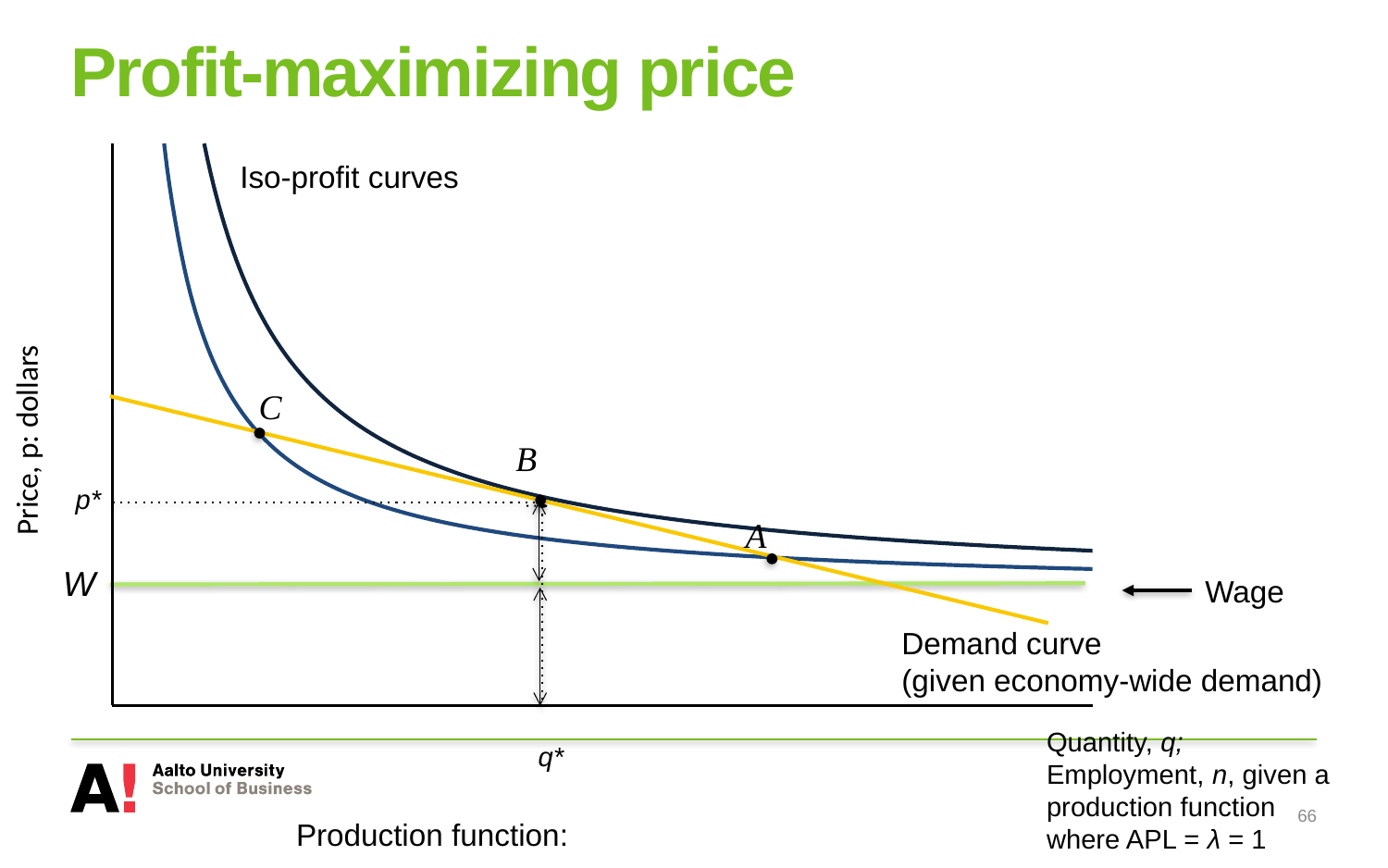
Which of the labeled points A, B or C lies at the highest price? C Which is higher on the price axis, p* or W? p* What is the label of the horizontal green line on the chart? W (Wage) What is the label of the vertical axis? Price, p: dollars How many labeled points (A, B, C) are marked on the chart? 3 What kind of chart is shown on the slide? line chart Which point lies at a higher price, point B or point A? B What is the yellow downward-sloping line labeled as? Demand curve (given economy-wide demand) Does the demand curve rise or fall as quantity increases along the x axis? fall Which labeled point corresponds to the quantity q* on the x axis? B How many iso-profit curves are drawn on the chart? 2 Which of the labeled points A, B or C lies at the lowest price? A